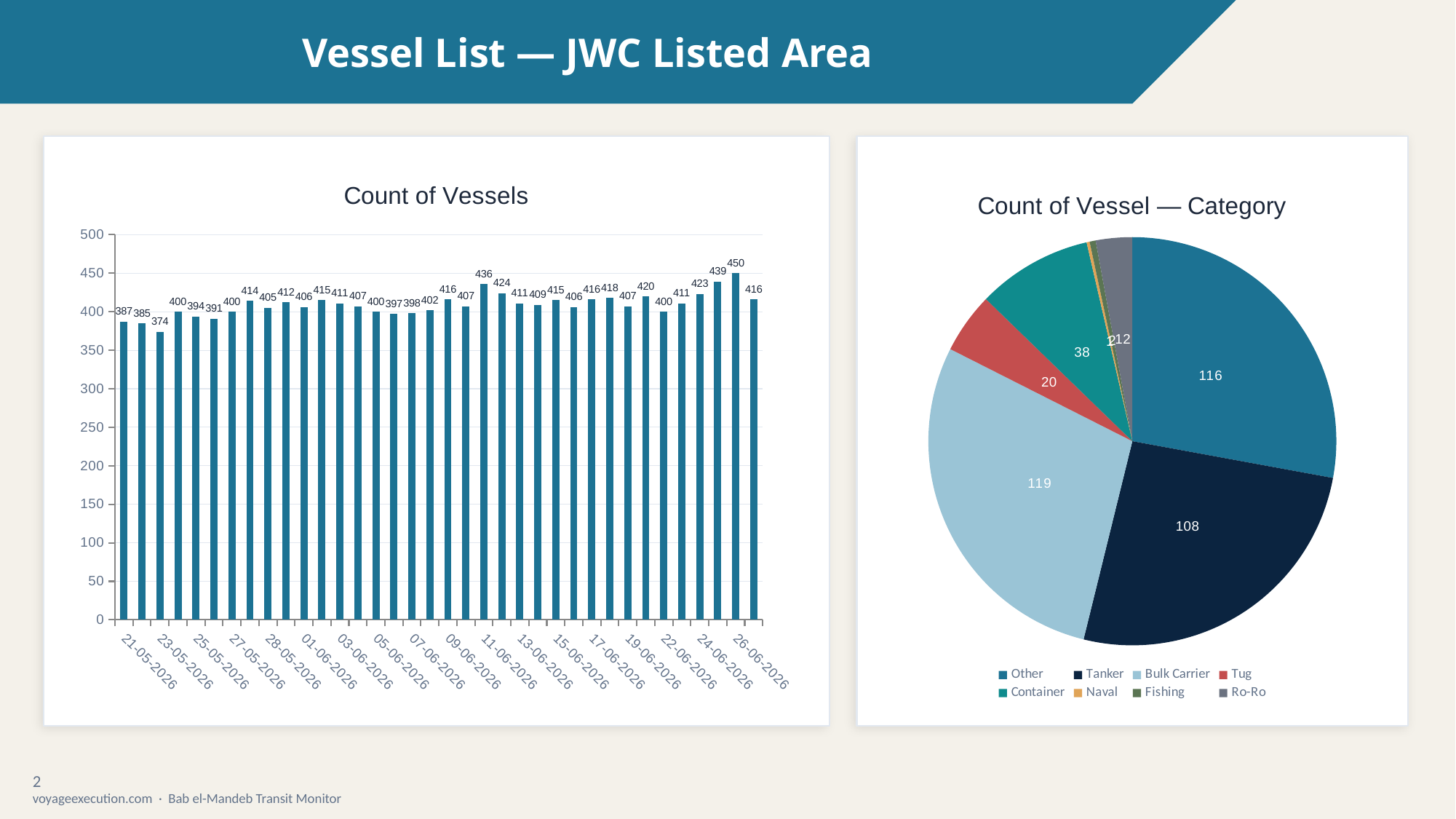
In the 'Count of Vessels' chart, what is the highest value shown? 450 In the 'Count of Vessels' chart, what is the value for 21-05-2026? 387 In the 'Count of Vessels' chart, what is the difference between the highest and lowest values? 76 In the 'Count of Vessels' chart, what is the lowest value shown? 374 What kind of chart is the 'Count of Vessel — Category' chart on the right? pie chart What kind of chart is the 'Count of Vessels' chart on the left? bar chart In the 'Count of Vessel — Category' pie chart, what is the value for Tanker? 108 In the 'Count of Vessel — Category' pie chart, what is the difference between Bulk Carrier and Tanker? 11 In the 'Count of Vessel — Category' pie chart, which is larger, Other or Tanker? Other In the 'Count of Vessel — Category' pie chart, what is the value for Container? 38 How many bars are plotted in the 'Count of Vessels' chart? 36 How many categories does the legend of the 'Count of Vessel — Category' pie chart list? 8